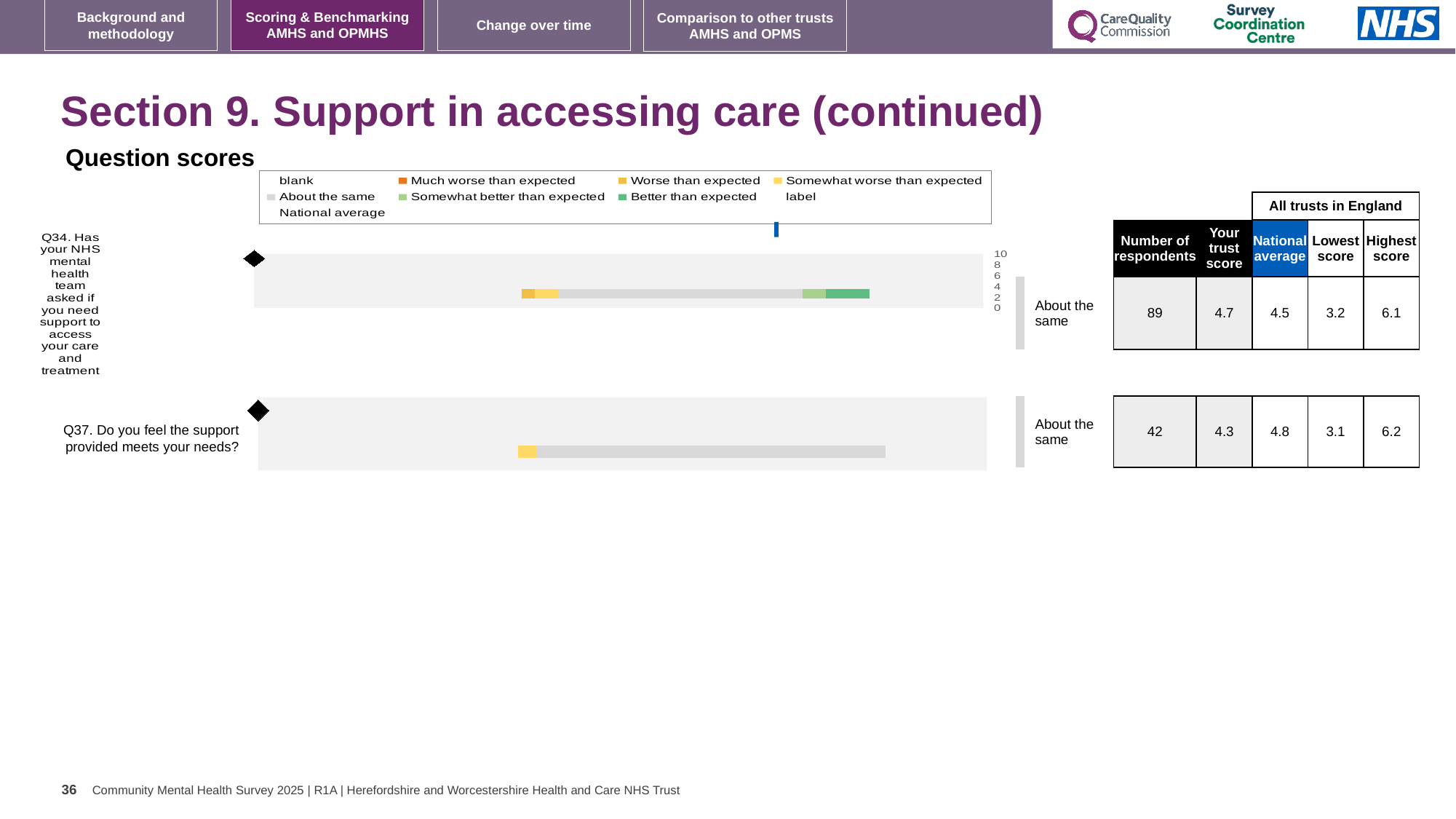
What is the difference between the trust score and the national average for Q34? 0.2 What kind of chart is used to show the question scores for Q34 and Q37? bar chart What is the national average score for Q37 (Do you feel the support provided meets your needs)? 4.8 What is the difference between the highest score and the lowest score for Q37? 3.1 What benchmark category is shown next to the bar for Q37? About the same Which legend entry is shown in orange? Much worse than expected What is the highest score among all trusts in England for Q34? 6.1 What is the trust score for Q34 (Has your NHS mental health team asked if you need support to access your care and treatment)? 4.7 How many respondents answered Q37? 42 How many questions (bars) are plotted in the question scores chart? 2 For Q37, which is larger: the trust score or the national average? national average For Q34, which is larger: the trust score or the national average? trust score